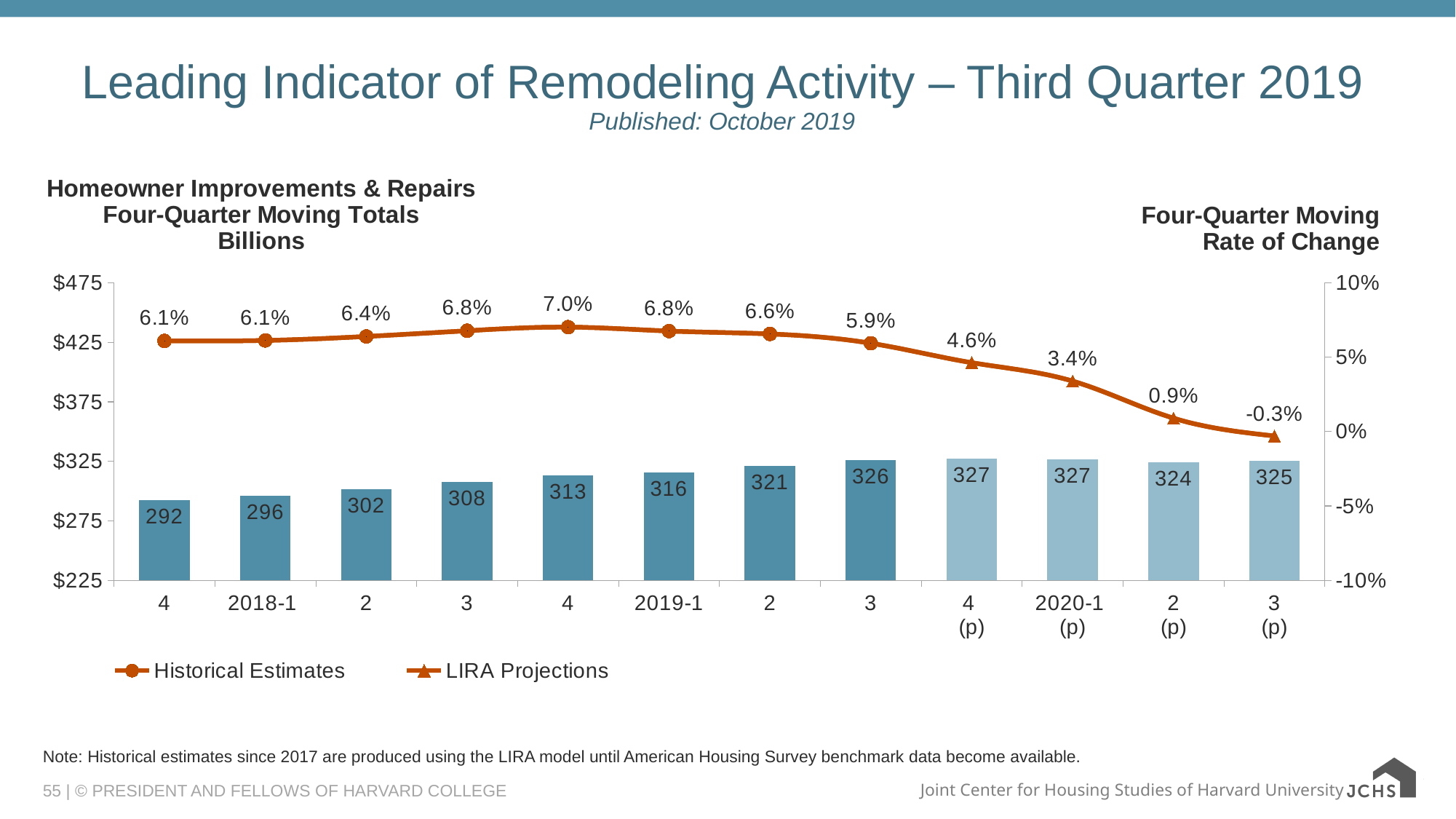
Which quarter has the lowest four-quarter moving total? 4 (2017) How many series does the legend list? 2 What is the difference between the four-quarter moving totals for 2019-3 and 2018-3? 18 What is the four-quarter moving total (in billions) for 2019-1? 316 Which quarter has the lowest four-quarter moving rate of change? 3 (p) (2020) Which is larger, the four-quarter moving total for 2020-2 (p) or for 2019-2? 2020-2 (p) What is the difference in the rate of change between 2018-4 and 2020-3 (p)? 7.3 percentage points How many quarters (bars) are shown on the chart? 12 Does the four-quarter moving rate of change rise or fall from 2019-3 to 2020-3 (p)? fall Which quarter has the highest four-quarter moving rate of change? 4 (2018) What is the four-quarter moving rate of change for 2020-1 (p)? 3.4% What is the four-quarter moving total for the third quarter of 2019? 326